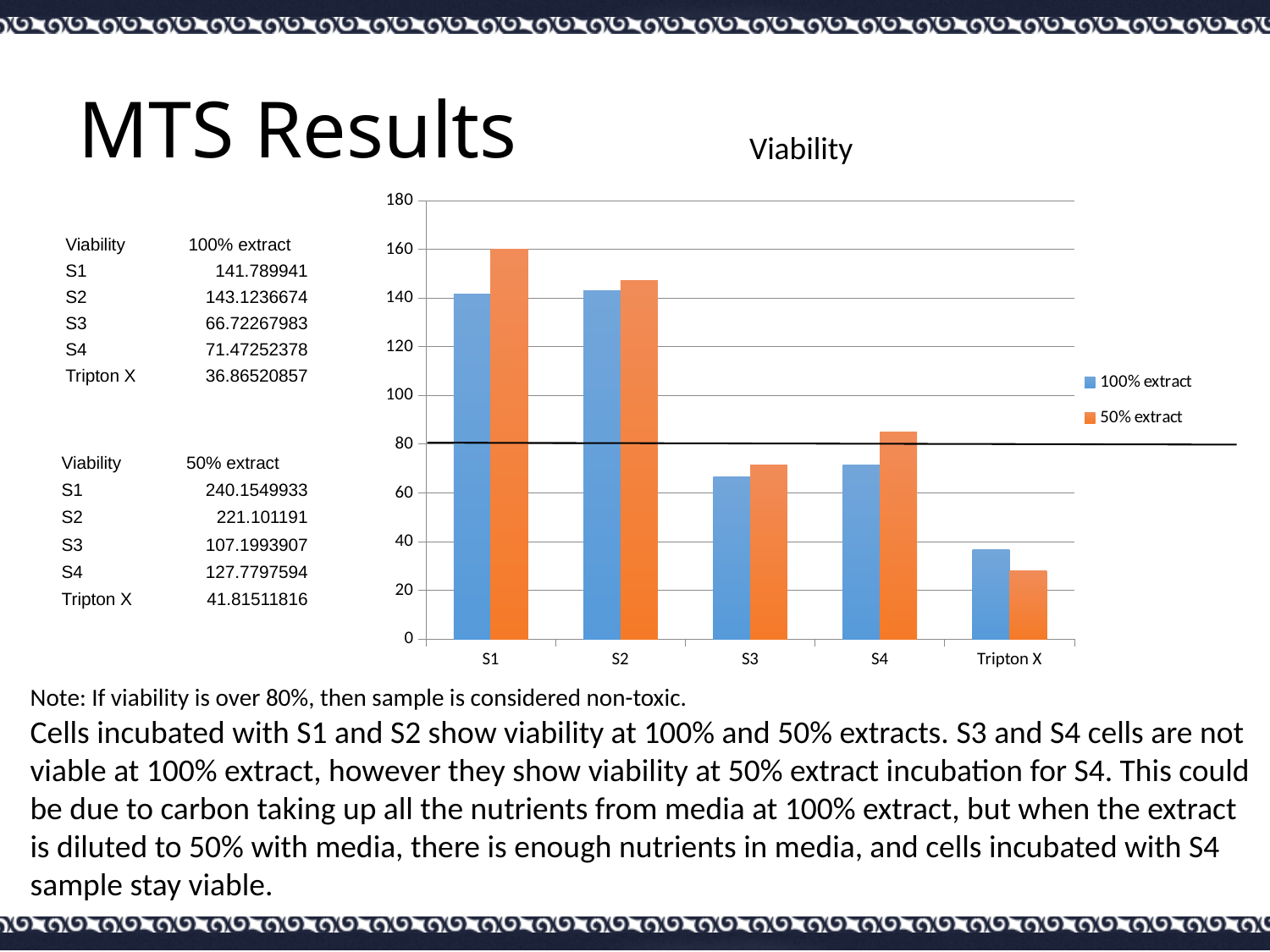
What kind of chart is shown on the slide? bar chart How many series does the chart legend list? 2 Is the 50% extract value for S1 greater or less than 140? greater Is the 50% extract value for Tripton X greater or less than 40? less How many categories are shown on the x axis of the chart? 5 Which category has the highest 50% extract bar? S1 Is the 100% extract value for S3 greater or less than 80? less What is the title of the chart? Viability For Tripton X, which series has the larger bar, 100% extract or 50% extract? 100% extract For S1, which series has the larger bar, 100% extract or 50% extract? 50% extract Which category has the lowest 50% extract bar? Tripton X Which category has the lowest 100% extract bar? Tripton X